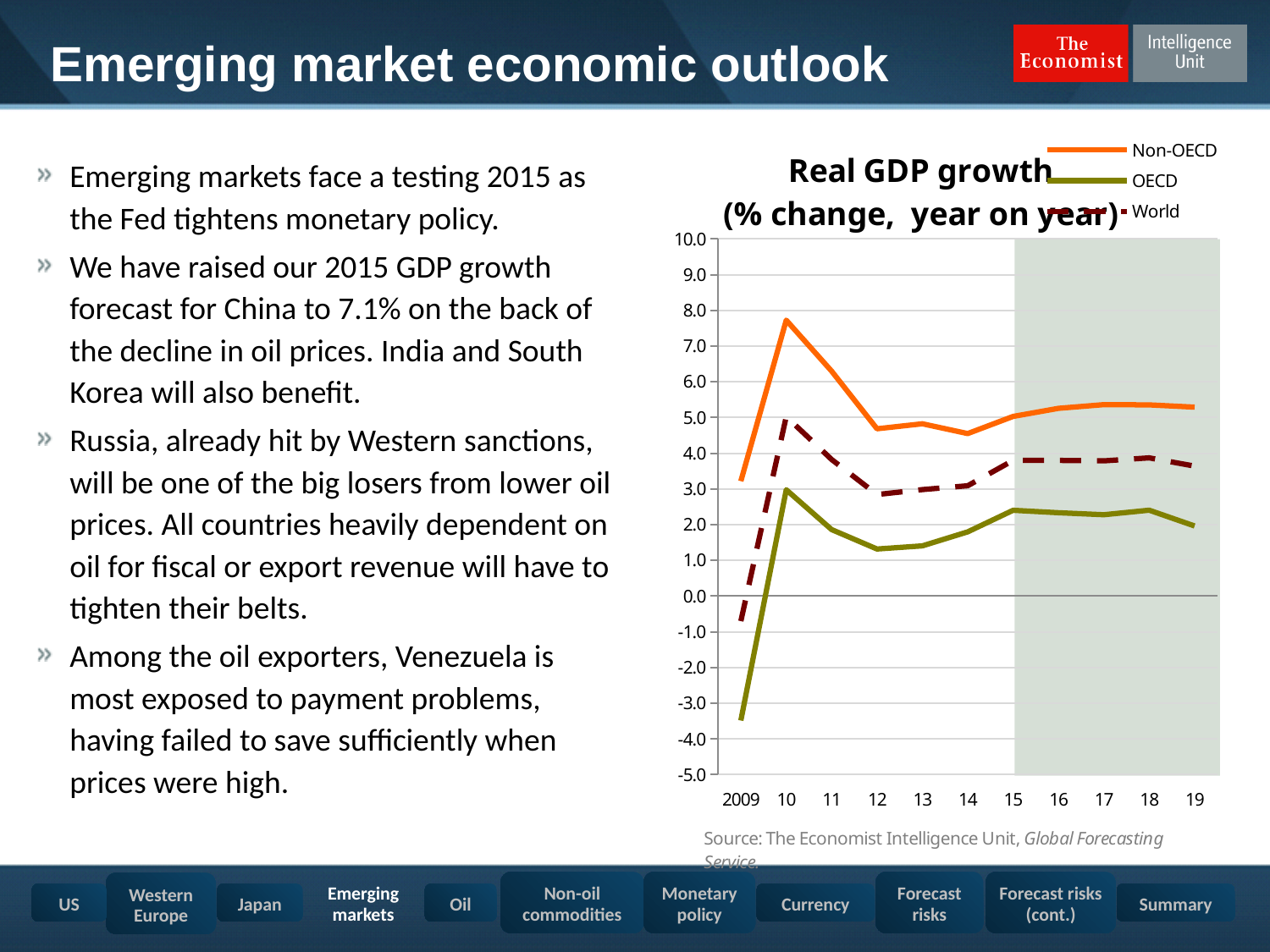
Is the OECD value for 2009 greater or less than -3.0? less Which series is drawn with a dashed line? World What kind of chart is shown on the slide? line chart What is the title of the chart? Real GDP growth (% change, year on year) Is the Non-OECD value for 2010 greater or less than 7.0? greater Is the World value for 2009 greater or less than 0.0? less How many series does the legend of the Real GDP growth chart list? 3 In 2012, which series has the higher value, Non-OECD or OECD? Non-OECD In which year does the Non-OECD series reach its highest value? 2010 In which year does the OECD series reach its lowest value? 2009 Does the Non-OECD series rise or fall between 2010 and 2012? fall How many years are shown along the x axis of the Real GDP growth chart? 11